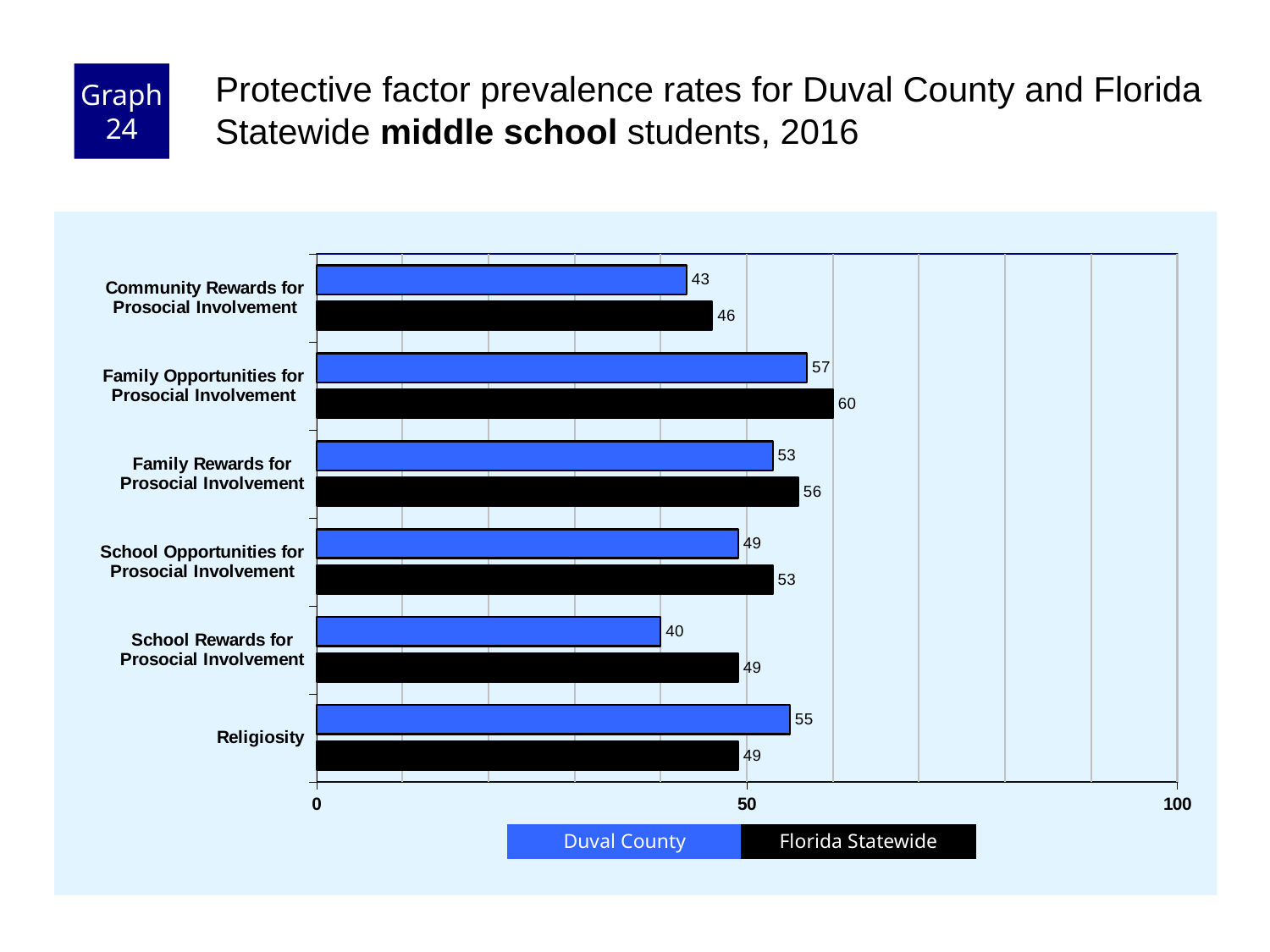
What is the difference between the Florida Statewide and Duval County values for School Rewards for Prosocial Involvement? 9 Which category has the lowest Duval County value? School Rewards for Prosocial Involvement What is the Duval County value for Religiosity? 55 How many categories are shown on the chart? 6 How many series does the legend list? 2 What is the Florida Statewide value for School Rewards for Prosocial Involvement? 49 What is the Florida Statewide value for Family Opportunities for Prosocial Involvement? 60 What is the Duval County value for Community Rewards for Prosocial Involvement? 43 Which category has the highest Florida Statewide value? Family Opportunities for Prosocial Involvement Is the Duval County value for Family Rewards for Prosocial Involvement greater or less than 50? greater What kind of chart is shown on the slide? bar chart For Religiosity, which is larger: the Duval County value or the Florida Statewide value? Duval County